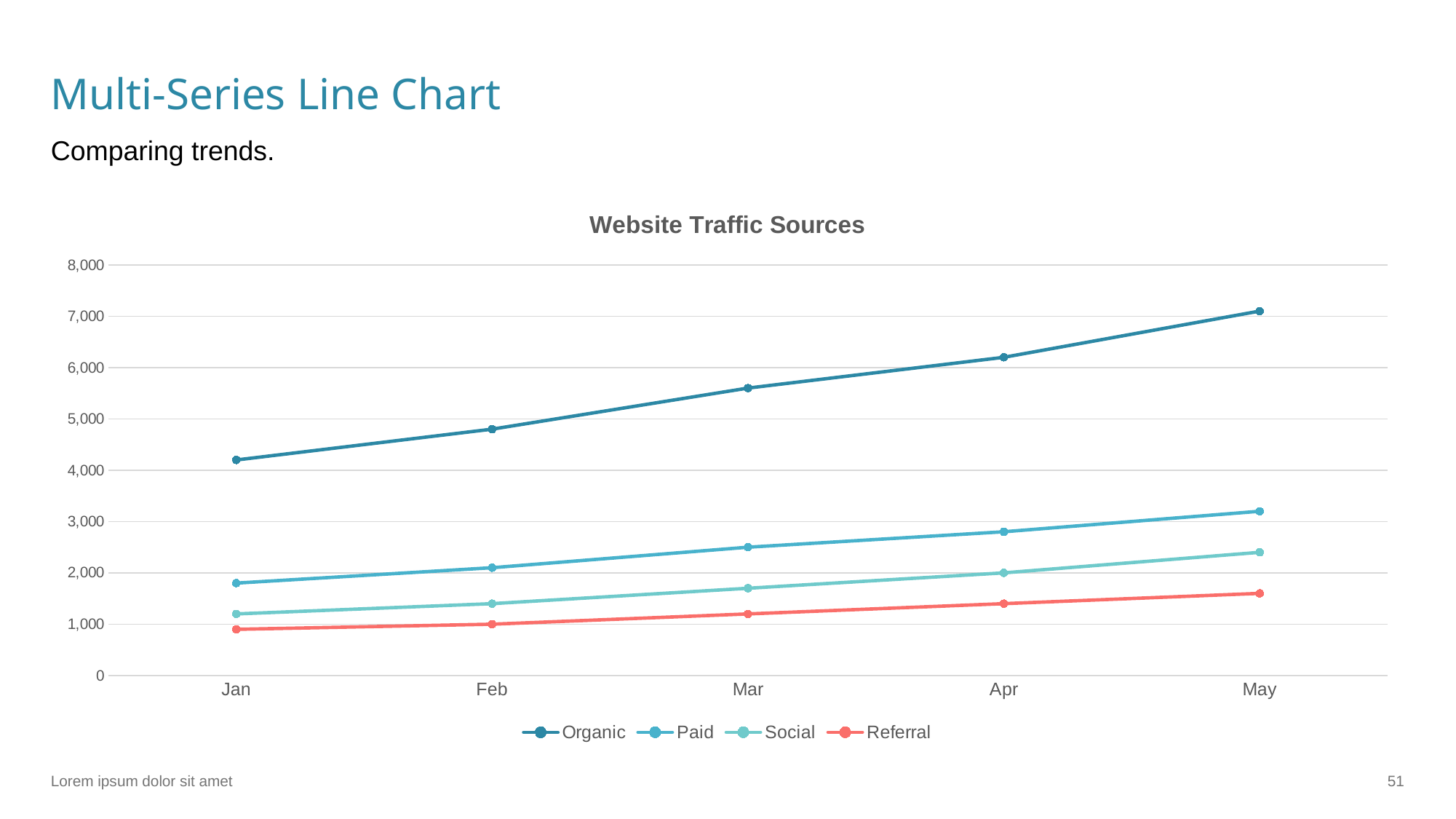
Which series has the lowest value in Jan? Referral Does the Organic series rise or fall from Jan to May? rise What kind of chart is shown on the slide? line chart Is the Organic value for Mar greater or less than 5,000? greater Which series has the highest value in May? Organic What is the title of the chart? Website Traffic Sources Is the Organic value for Jan greater or less than 4,000? greater In Mar, which is larger, the Paid value or the Social value? Paid How many months are plotted along the x axis? 5 Is the Paid value for May greater or less than 3,000? greater How many series does the legend list? 4